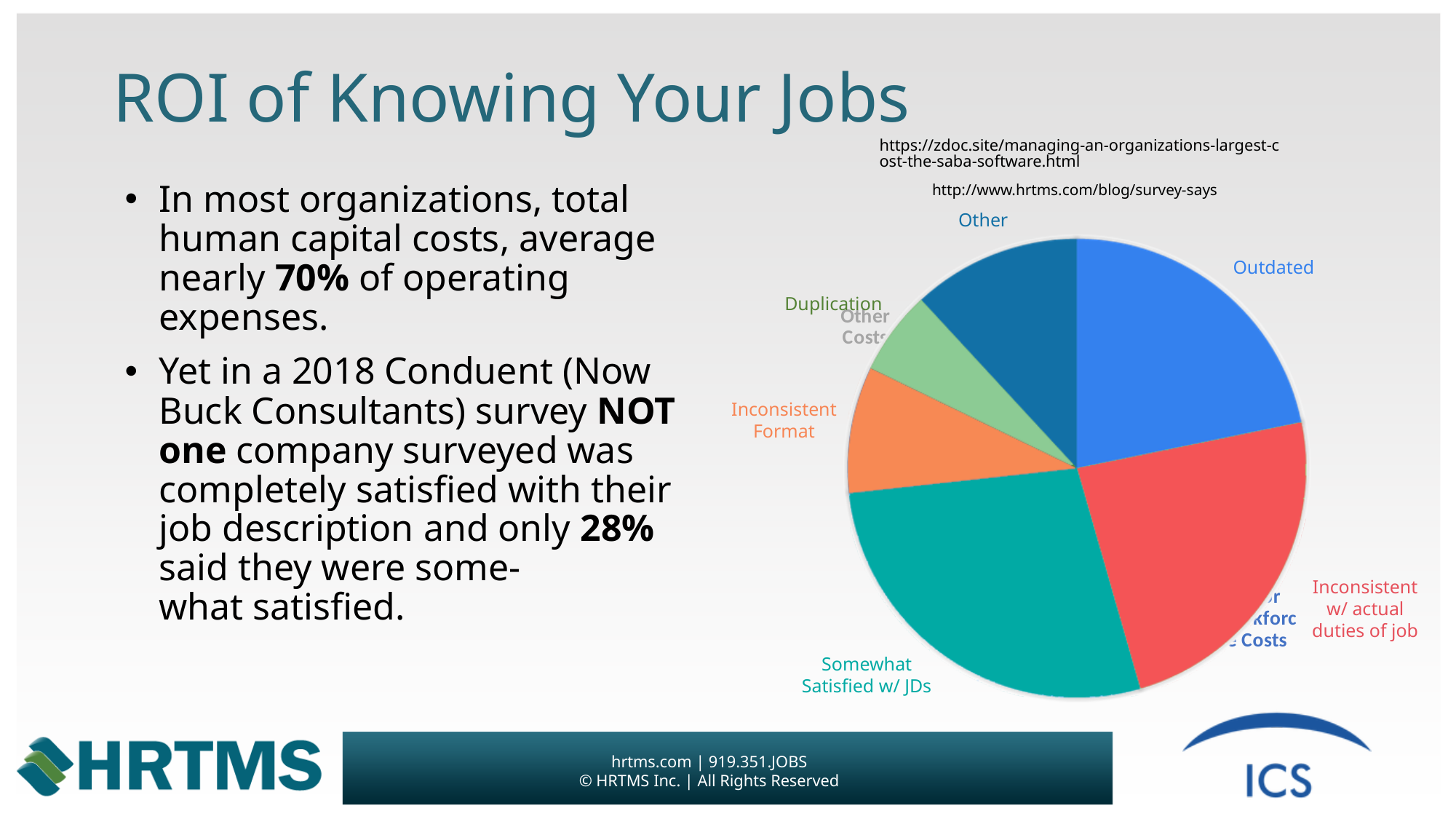
What colour is the Inconsistent Format slice? orange Which slice of the pie chart is the smallest? Duplication Which slice of the pie chart is the largest? Somewhat Satisfied w/ JDs What kind of chart is shown on the slide? pie chart Which slice is larger, Other or Duplication? Other How many slices does the pie chart have? 6 What colour is the Somewhat Satisfied w/ JDs slice? teal Which slice is larger, Somewhat Satisfied w/ JDs or Outdated? Somewhat Satisfied w/ JDs Which slice is larger, Outdated or Inconsistent w/ actual duties of job? Inconsistent w/ actual duties of job